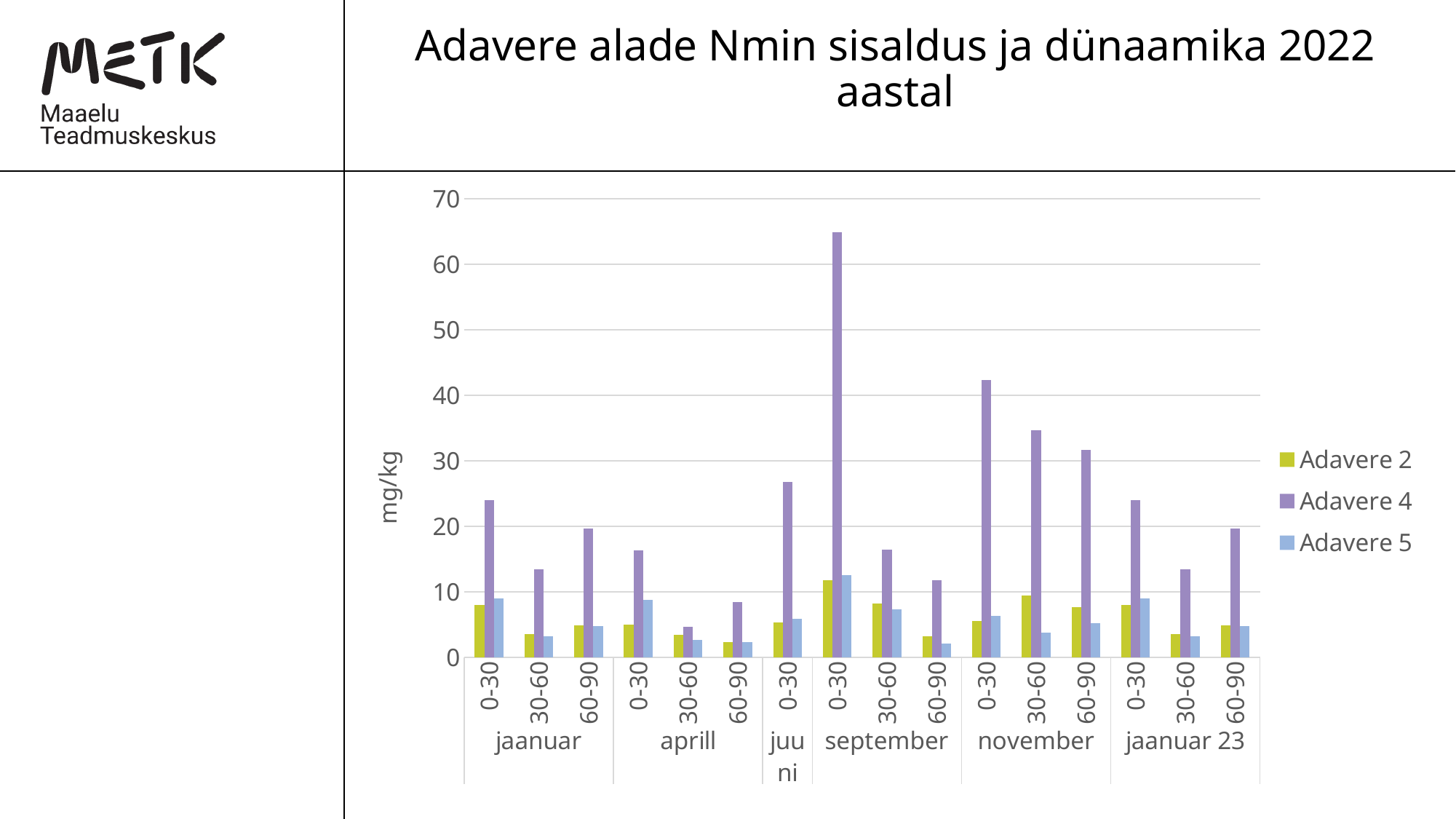
In which month and depth does Adavere 4 reach its highest value? september 0-30 Is the Adavere 2 value for september 0-30 greater or less than 10? greater Is the Adavere 4 value for aprill 30-60 greater or less than 10? less What is the title of the chart? Adavere alade Nmin sisaldus ja dünaamika 2022 aastal Which series has the larger value at jaanuar 0-30, Adavere 5 or Adavere 4? Adavere 4 Which series has the larger value at september 0-30, Adavere 2 or Adavere 4? Adavere 4 What unit is shown on the vertical axis label? mg/kg How many series does the legend list? 3 Is the Adavere 4 value for september 0-30 greater or less than 60? greater What kind of chart is shown on the slide? bar chart How many month groups are shown along the x axis? 6